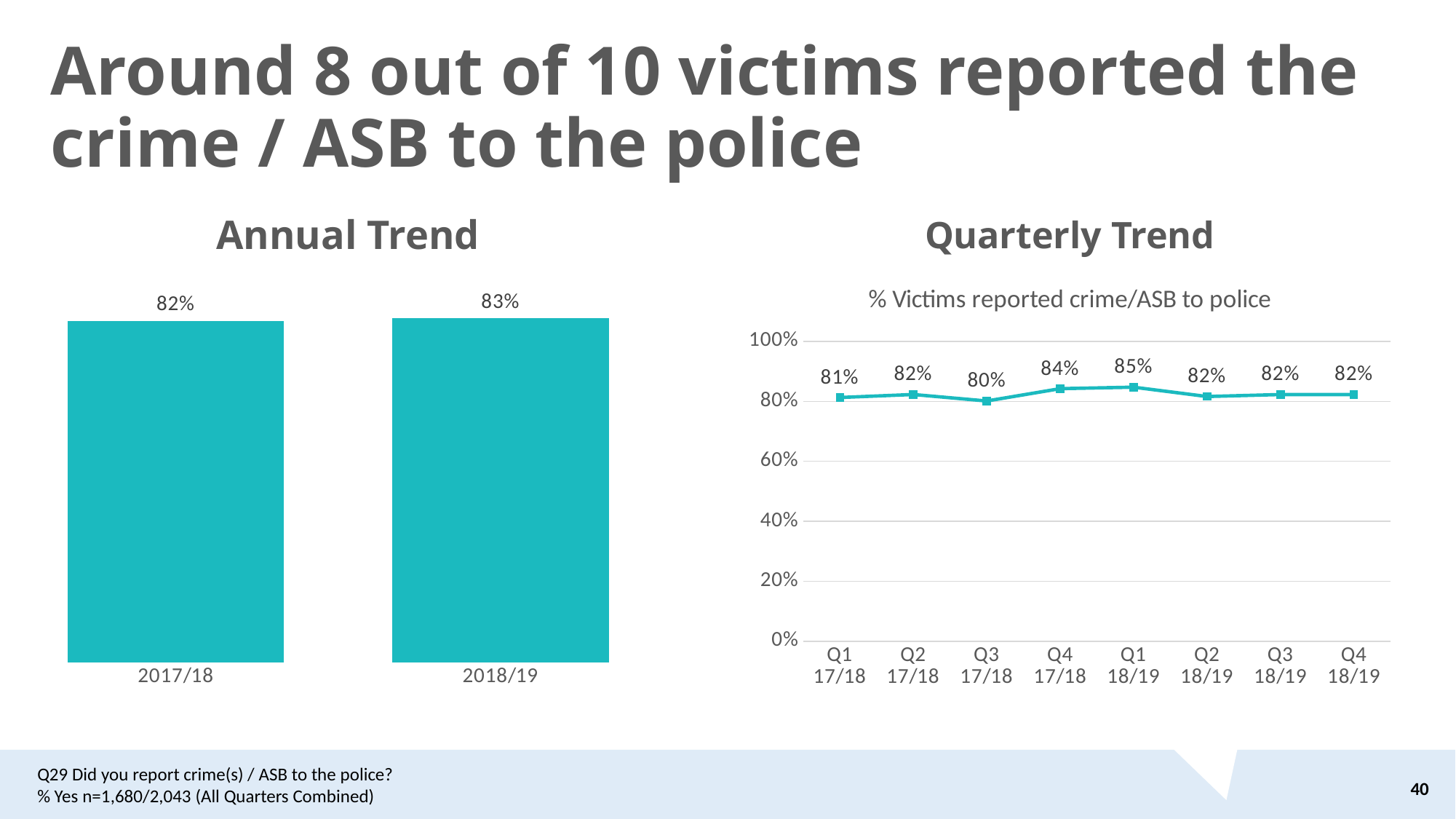
How many categories does the Annual Trend chart show? 2 In the Annual Trend chart, what is the value for 2018/19? 83% What kind of chart is the Annual Trend chart? bar chart How many data points are plotted in the Quarterly Trend chart? 8 In the Annual Trend chart, what is the difference between the 2018/19 and 2017/18 values? 1% In the Quarterly Trend chart, what is the value for Q1 18/19? 85% In the Quarterly Trend chart, which quarter has the highest value? Q1 18/19 In the Quarterly Trend chart, what is the value for Q3 17/18? 80% In the Quarterly Trend chart, which quarter has the lowest value? Q3 17/18 What kind of chart is the Quarterly Trend chart? line chart In the Quarterly Trend chart, what is the difference between the Q1 18/19 and Q3 17/18 values? 5% In the Annual Trend chart, what is the value for 2017/18? 82%